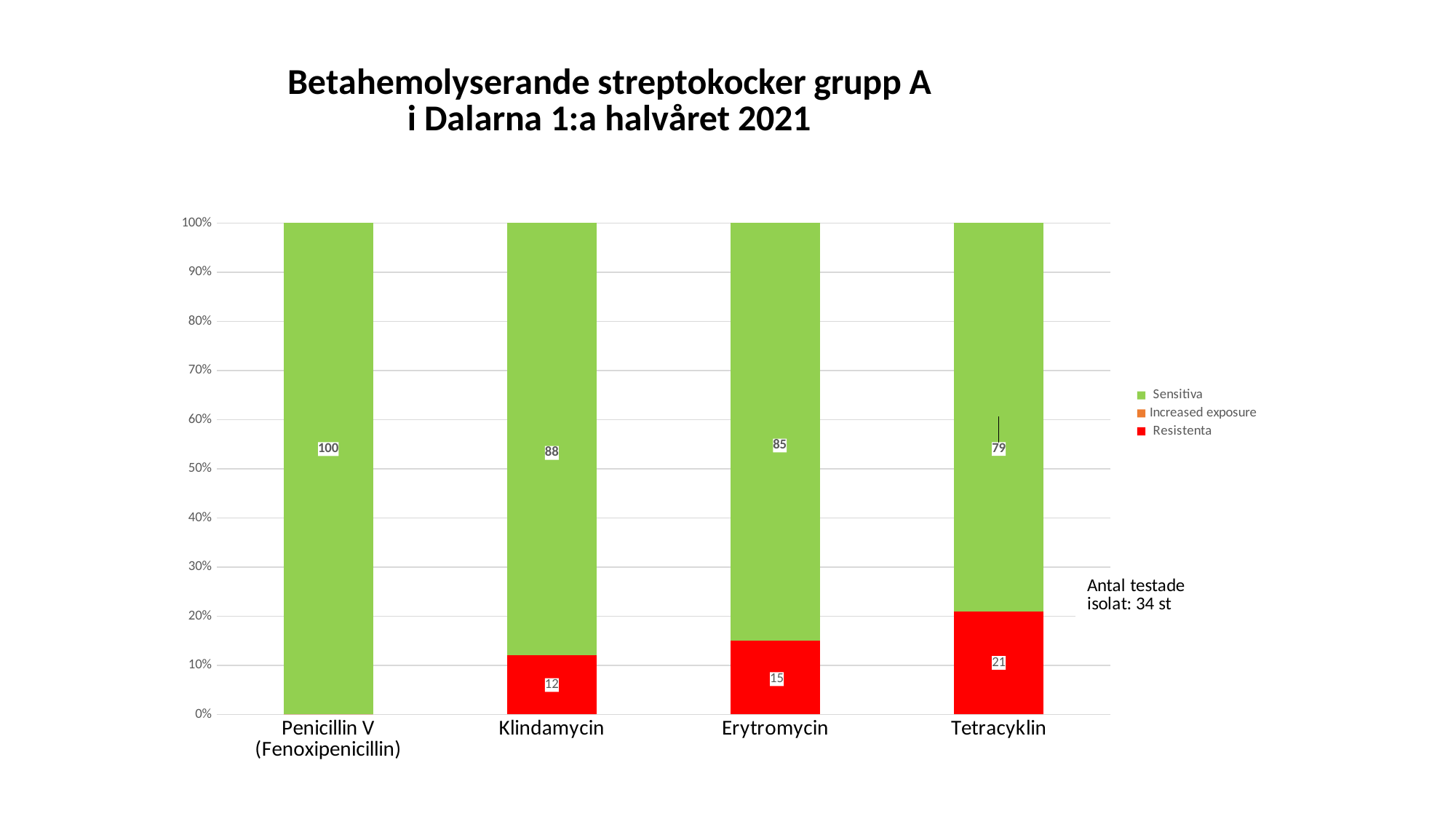
How many series does the legend list? 3 What is the Resistenta value for Tetracyklin? 21 What kind of chart is shown? Stacked bar chart Which antibiotic has the lowest Sensitiva value? Tetracyklin What is the difference between the Sensitiva values for Klindamycin and Tetracyklin? 9 Which antibiotic has the highest Resistenta value? Tetracyklin What is the Sensitiva value for Klindamycin? 88 What is the Resistenta value for Erytromycin? 15 How many antibiotics are shown on the x axis? 4 What is the Sensitiva value for Penicillin V (Fenoxipenicillin)? 100 How many tested isolates does the slide report? 34 st Which has a larger Resistenta value, Klindamycin or Erytromycin? Erytromycin